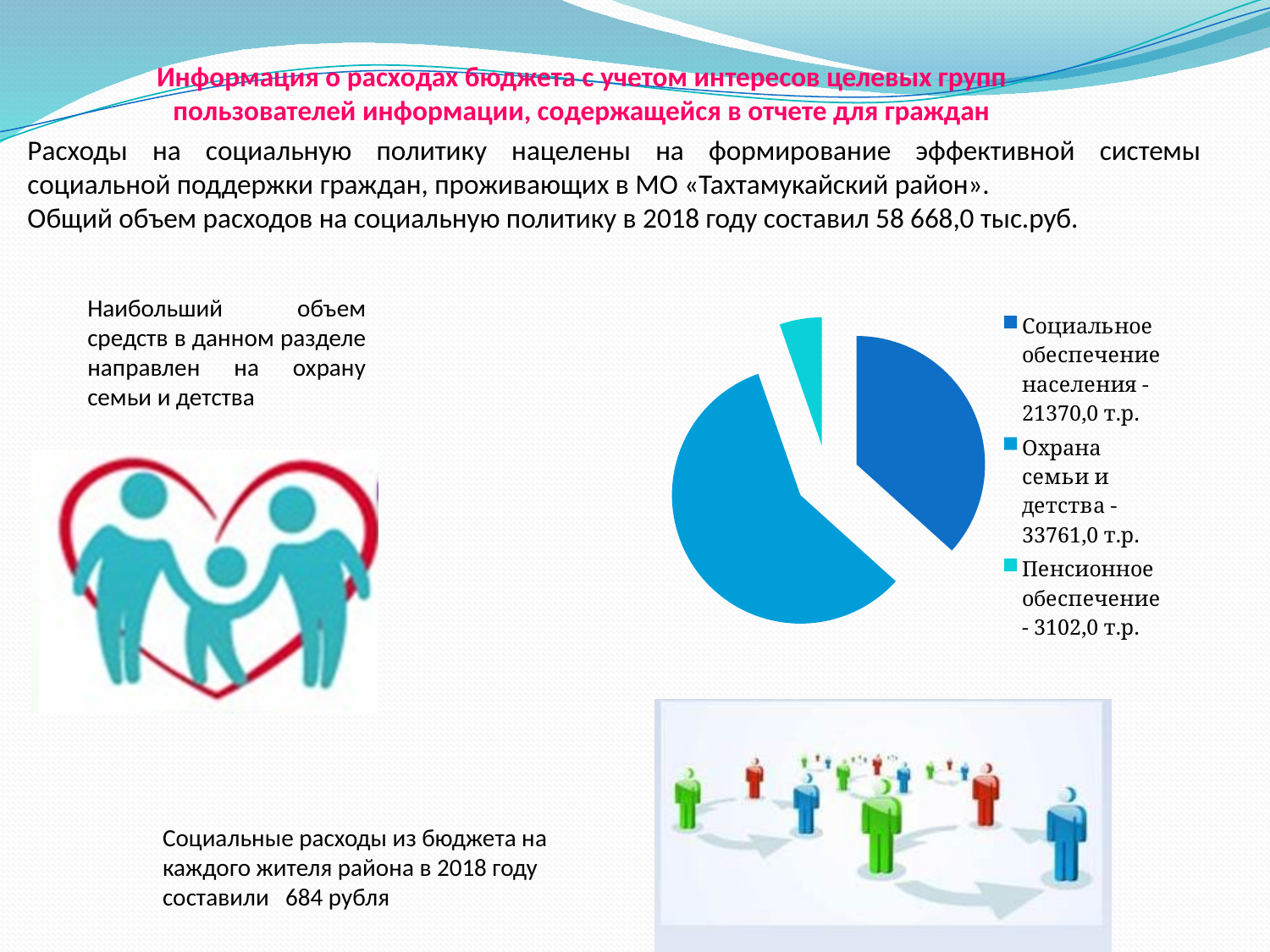
What colour is the slice for Пенсионное обеспечение in the pie chart? Light blue (cyan) How many slices does the pie chart have? 3 What value does the legend give for Пенсионное обеспечение? 3102,0 т.р. What value does the legend give for Социальное обеспечение населения? 21370,0 т.р. What is the difference between Охрана семьи и детства and Социальное обеспечение населения? 12391,0 т.р. Which category has the largest slice of the pie chart? Охрана семьи и детства What kind of chart is shown on the slide? Pie chart Which is larger: Социальное обеспечение населения or Пенсионное обеспечение? Социальное обеспечение населения Which category has the smallest slice of the pie chart? Пенсионное обеспечение How many entries does the pie chart's legend list? 3 What is the difference between Социальное обеспечение населения and Пенсионное обеспечение? 18268,0 т.р. What value does the legend give for Охрана семьи и детства? 33761,0 т.р.